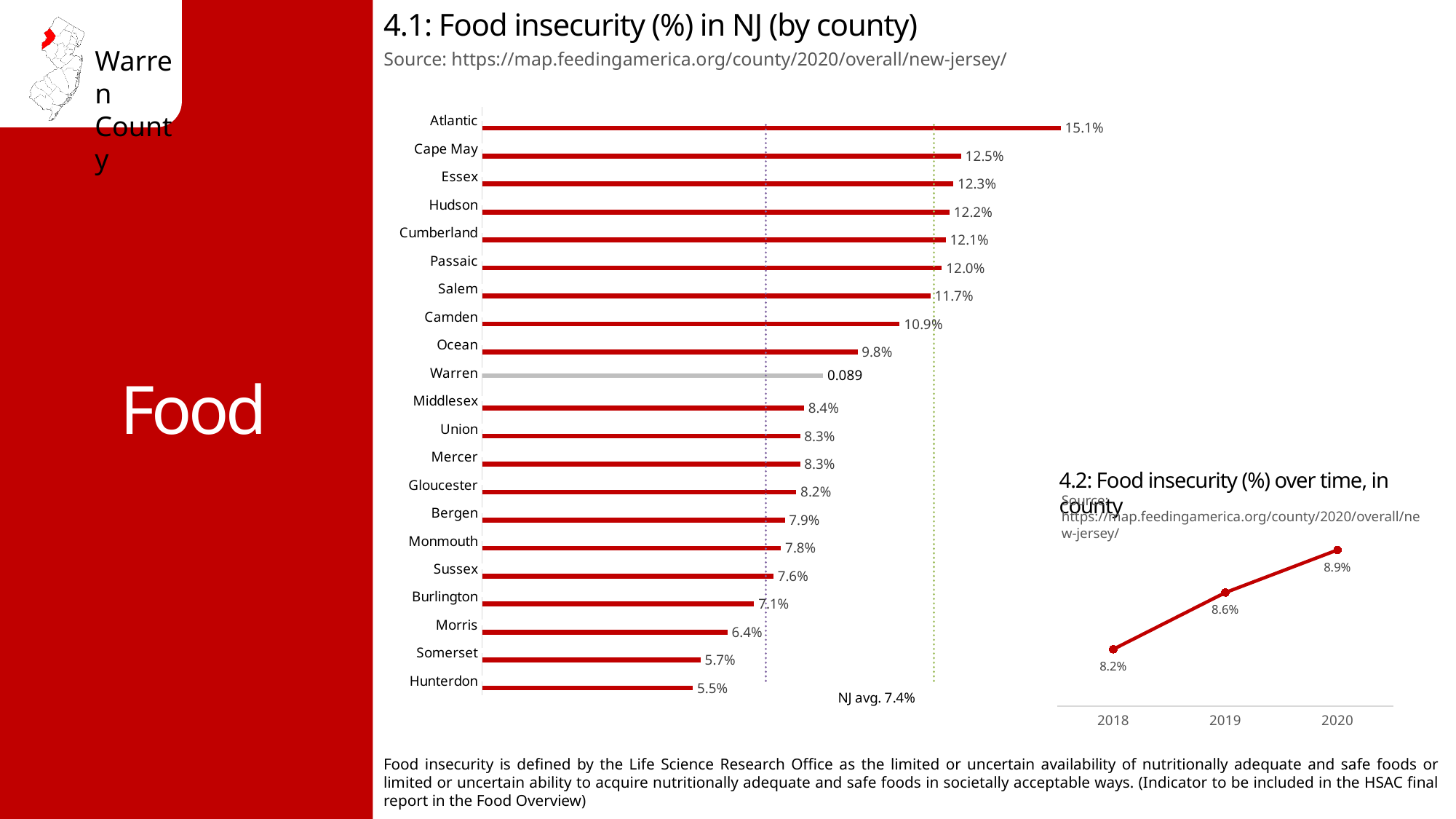
In chart 4.2 (Food insecurity (%) over time, in county), what is the difference between the 2020 and 2018 values? 0.7% In chart 4.1 (Food insecurity (%) in NJ by county), what is the difference between Atlantic and Cape May? 2.6% In chart 4.1 (Food insecurity (%) in NJ by county), which county has the highest value? Atlantic In chart 4.1 (Food insecurity (%) in NJ by county), which county has the lowest value? Hunterdon In chart 4.1 (Food insecurity (%) in NJ by county), how many counties are plotted? 21 In chart 4.1 (Food insecurity (%) in NJ by county), what is the value for Atlantic? 15.1% In chart 4.1 (Food insecurity (%) in NJ by county), what is the value for Hunterdon? 5.5% In chart 4.1 (Food insecurity (%) in NJ by county), what data label is shown for Warren? 0.089 In chart 4.2 (Food insecurity (%) over time, in county), what is the value for 2018? 8.2% What kind of chart is chart 4.1 (Food insecurity (%) in NJ by county)? Bar chart In chart 4.2 (Food insecurity (%) over time, in county), do the values rise or fall from 2018 to 2020? Rise In chart 4.1 (Food insecurity (%) in NJ by county), which is larger, Camden or Ocean? Camden